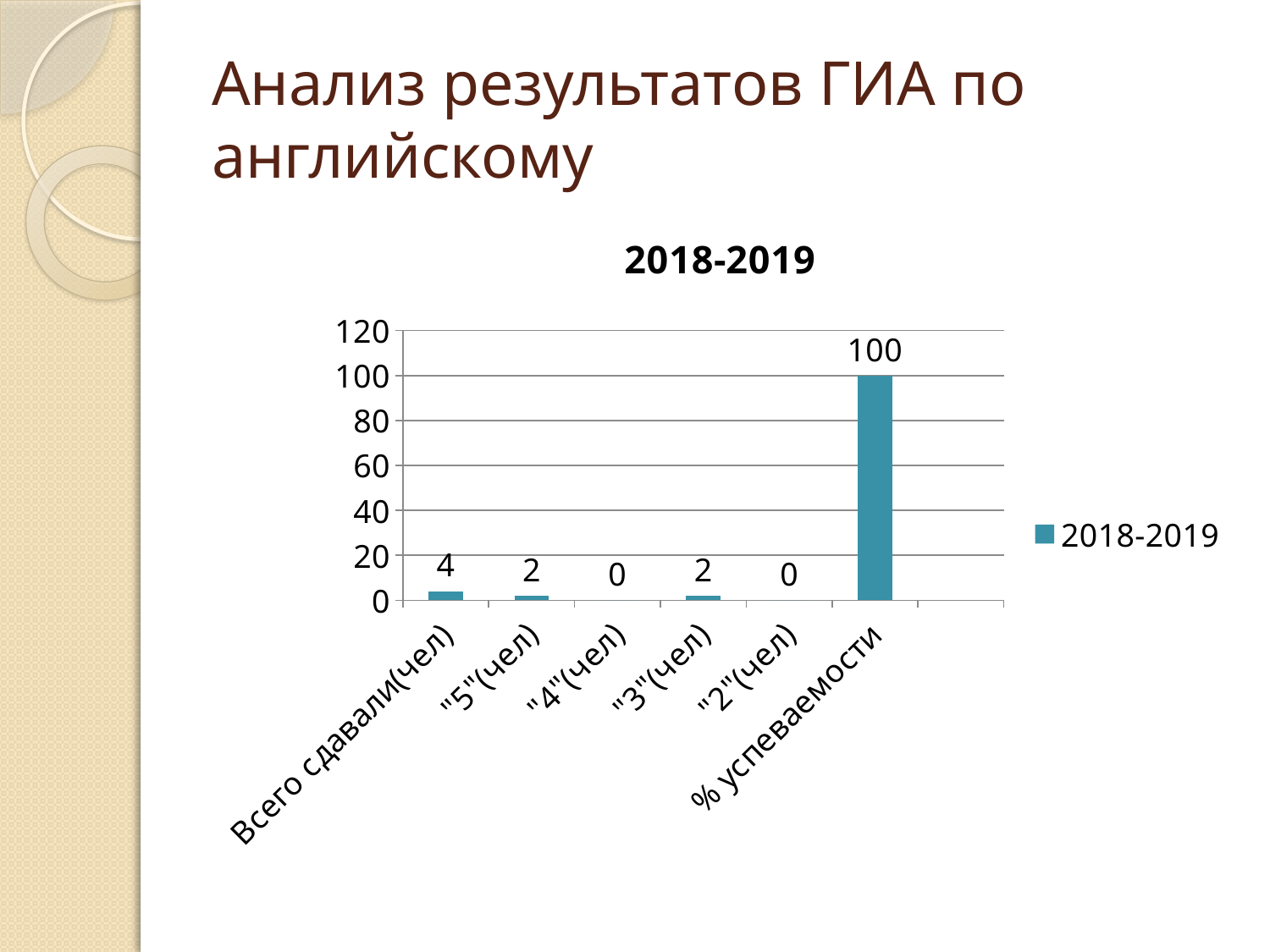
What is the title of the chart? 2018-2019 What is the difference between the values for "Всего сдавали(чел)" and ""3"(чел)"? 2 What is the value for ""5"(чел)"? 2 What is the value for "% успеваемости"? 100 How many series does the legend list? 1 What is the highest value shown on the y axis? 120 Which category has the highest value? % успеваемости What is the value for "Всего сдавали(чел)"? 4 Which is larger, the value for ""5"(чел)" or the value for ""2"(чел)"? "5"(чел) How many categories are shown on the x axis? 6 What kind of chart is shown? bar chart What is the value for ""4"(чел)"? 0